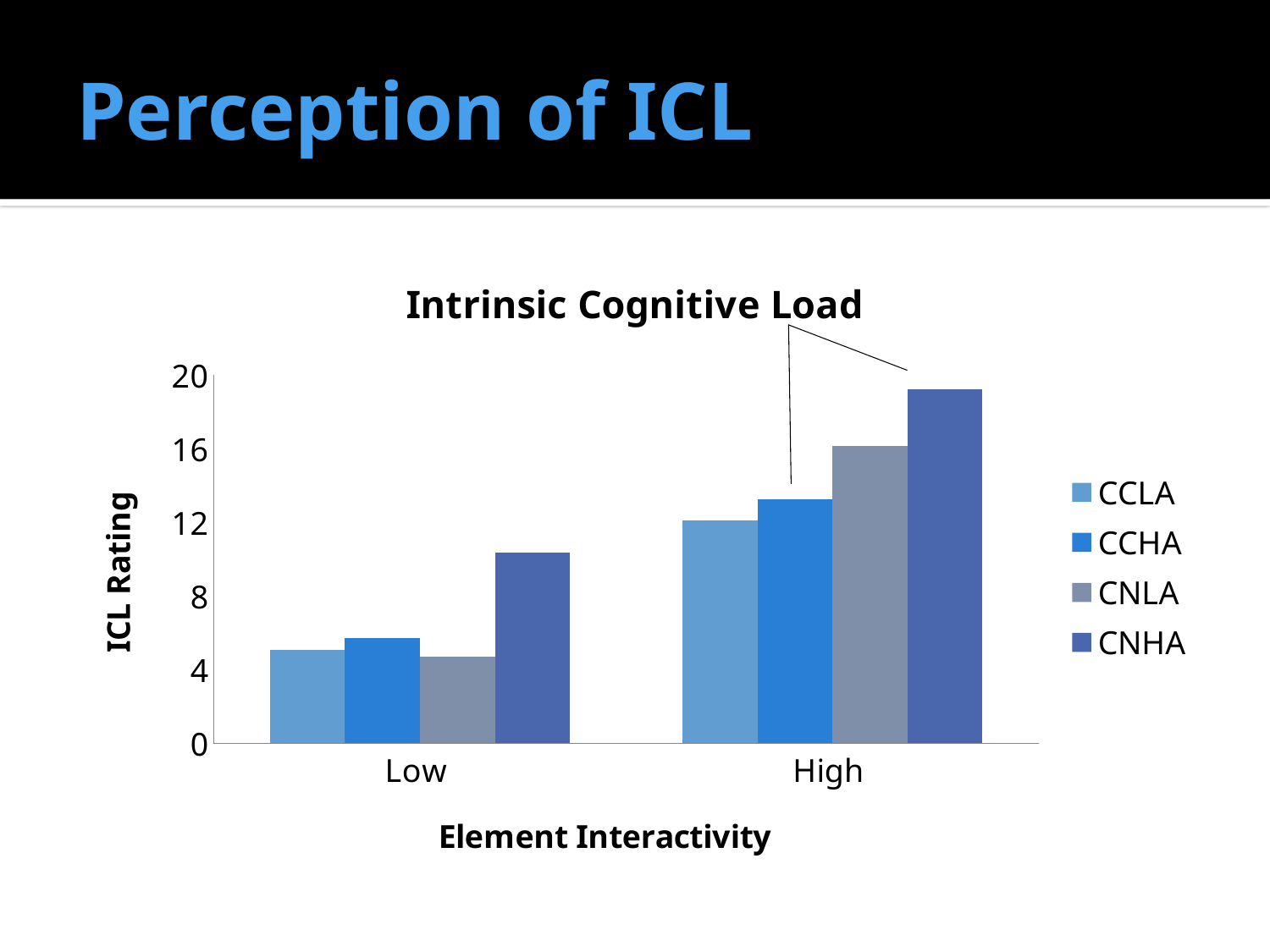
At High element interactivity, which is larger: the ICL Rating for CNHA or for CNLA? CNHA Which series has the highest ICL Rating in the Low element interactivity category? CNHA Is the ICL Rating for CNHA at High element interactivity greater or less than 16? greater Is the ICL Rating for CCHA at High element interactivity greater or less than 12? greater What is the title of the chart? Intrinsic Cognitive Load Which series has the highest ICL Rating in the High element interactivity category? CNHA What kind of chart is shown on the slide? bar chart Do the ICL Ratings rise or fall from Low to High element interactivity? rise How many categories are shown on the x axis? 2 Is the ICL Rating for CCLA at Low element interactivity greater or less than 8? less How many series does the legend list? 4